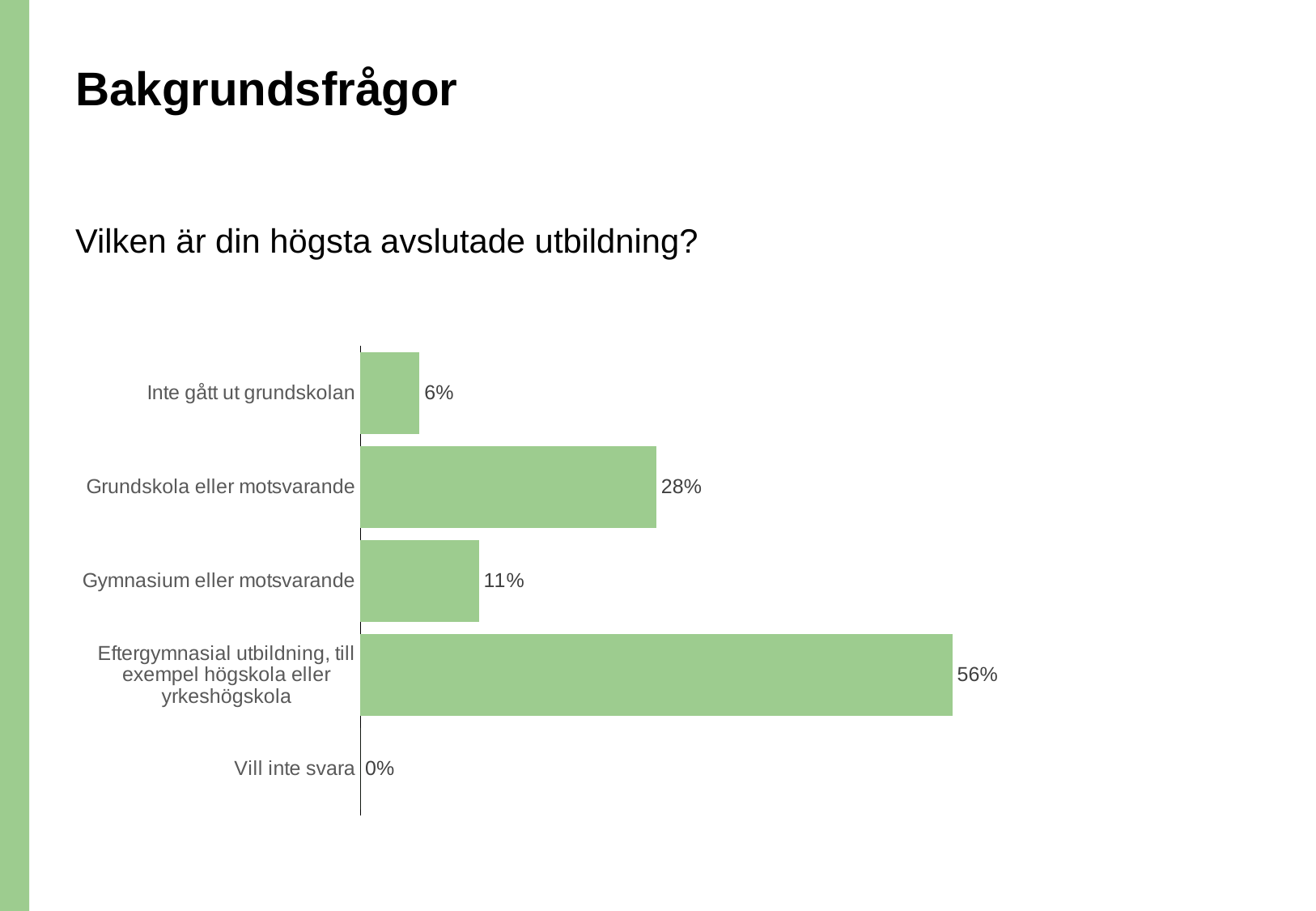
Which category has the highest value? Eftergymnasial utbildning, till exempel högskola eller yrkeshögskola What is the value for "Vill inte svara"? 0% What is the difference between the values for "Gymnasium eller motsvarande" and "Inte gått ut grundskolan"? 5% What is the value for "Gymnasium eller motsvarande"? 11% What kind of chart is shown on the slide? Bar chart What is the value for "Grundskola eller motsvarande"? 28% Which category has the lowest value? Vill inte svara What is the difference between the values for "Eftergymnasial utbildning, till exempel högskola eller yrkeshögskola" and "Grundskola eller motsvarande"? 28% What is the value for "Inte gått ut grundskolan"? 6% How many categories are shown in the chart? 5 Which is larger, the value for "Grundskola eller motsvarande" or the value for "Gymnasium eller motsvarande"? Grundskola eller motsvarande What question does the chart on the slide answer? Vilken är din högsta avslutade utbildning?